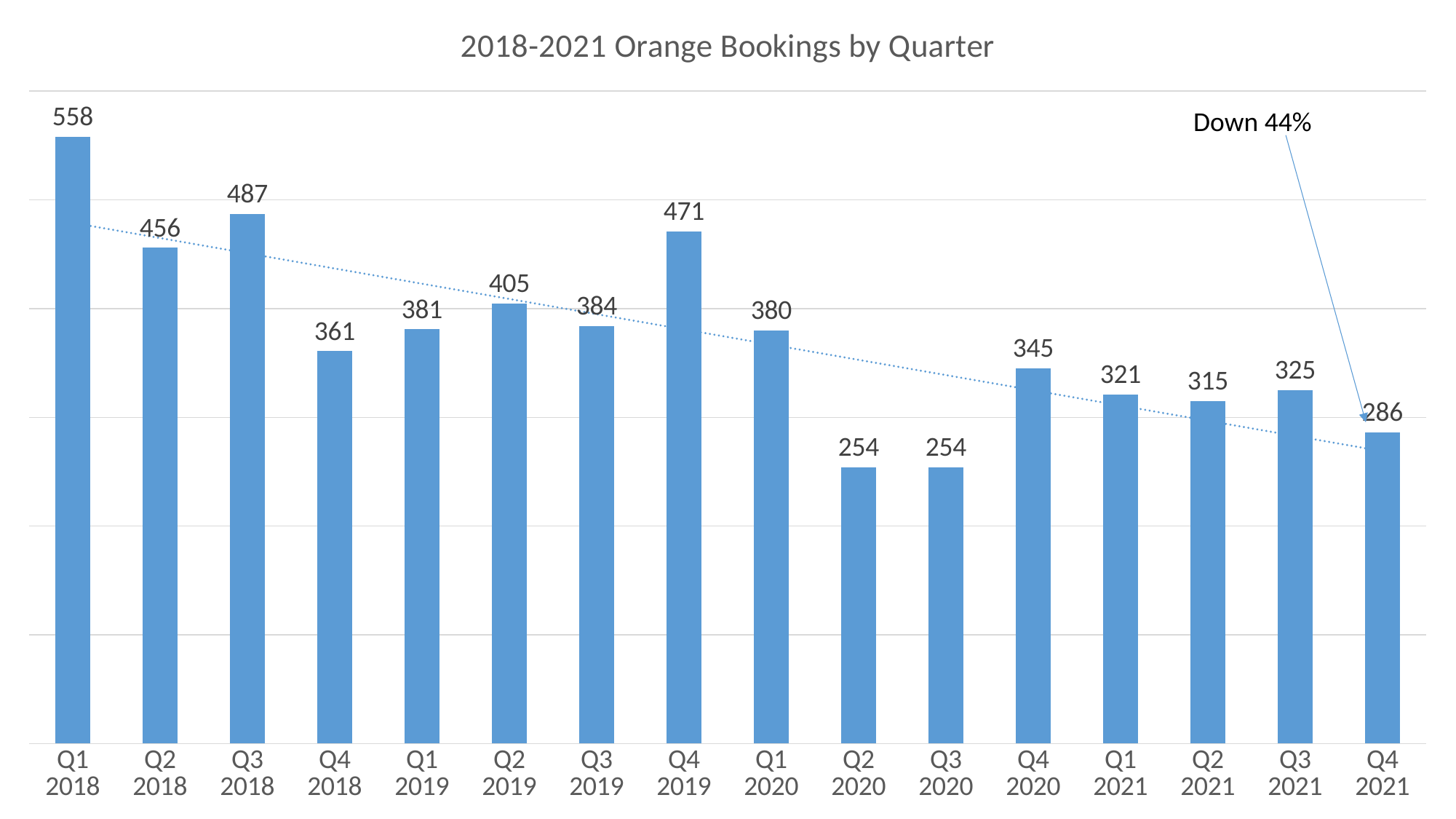
Which is larger, Q3 2018 or Q4 2019? Q3 2018 Which quarters share the lowest value? Q2 2020 and Q3 2020 What is the value for Q1 2018? 558 What is the title of the chart? 2018-2021 Orange Bookings by Quarter Do the values generally rise or fall from Q1 2018 to Q4 2021? Fall How many quarters are shown on the chart? 16 Which quarter has the highest value? Q1 2018 What is the difference between Q1 2018 and Q4 2021? 272 What is the value for Q4 2021? 286 What is the value for Q4 2019? 471 What kind of chart is this? Bar chart What does the annotation pointing to Q4 2021 say? Down 44%